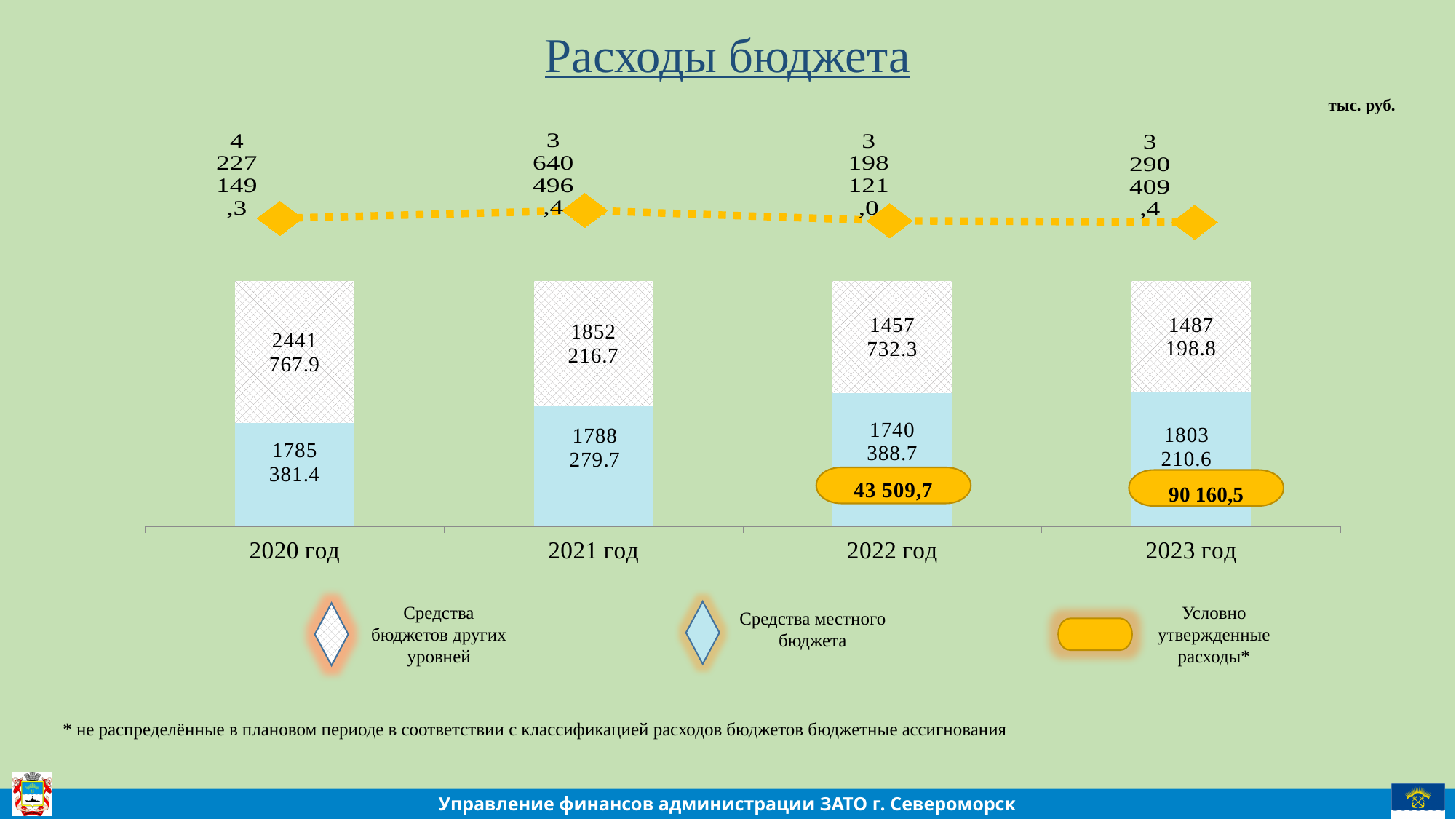
What is the value of 'Средства местного бюджета' for 2022 год? 1740 388.7 Which is larger in 2021 год: 'Средства бюджетов других уровней' or 'Средства местного бюджета'? Средства бюджетов других уровней What is the value of 'Условно утвержденные расходы' for 2023 год? 90 160,5 How many series does the legend list? 3 What is the total budget expenditure shown by the diamond marker for 2021 год? 3 640 496,4 What is the value of 'Средства бюджетов других уровней' for 2020 год? 2441 767.9 How many years are shown on the x axis? 4 In which year is the total expenditure (diamond marker) the highest? 2020 год Does the total expenditure (diamond marker) rise or fall from 2020 год to 2022 год? Fall In which year is 'Средства местного бюджета' the highest? 2023 год In which year is the total expenditure (diamond marker) the lowest? 2022 год What kind of chart is this? Stacked bar chart with a line